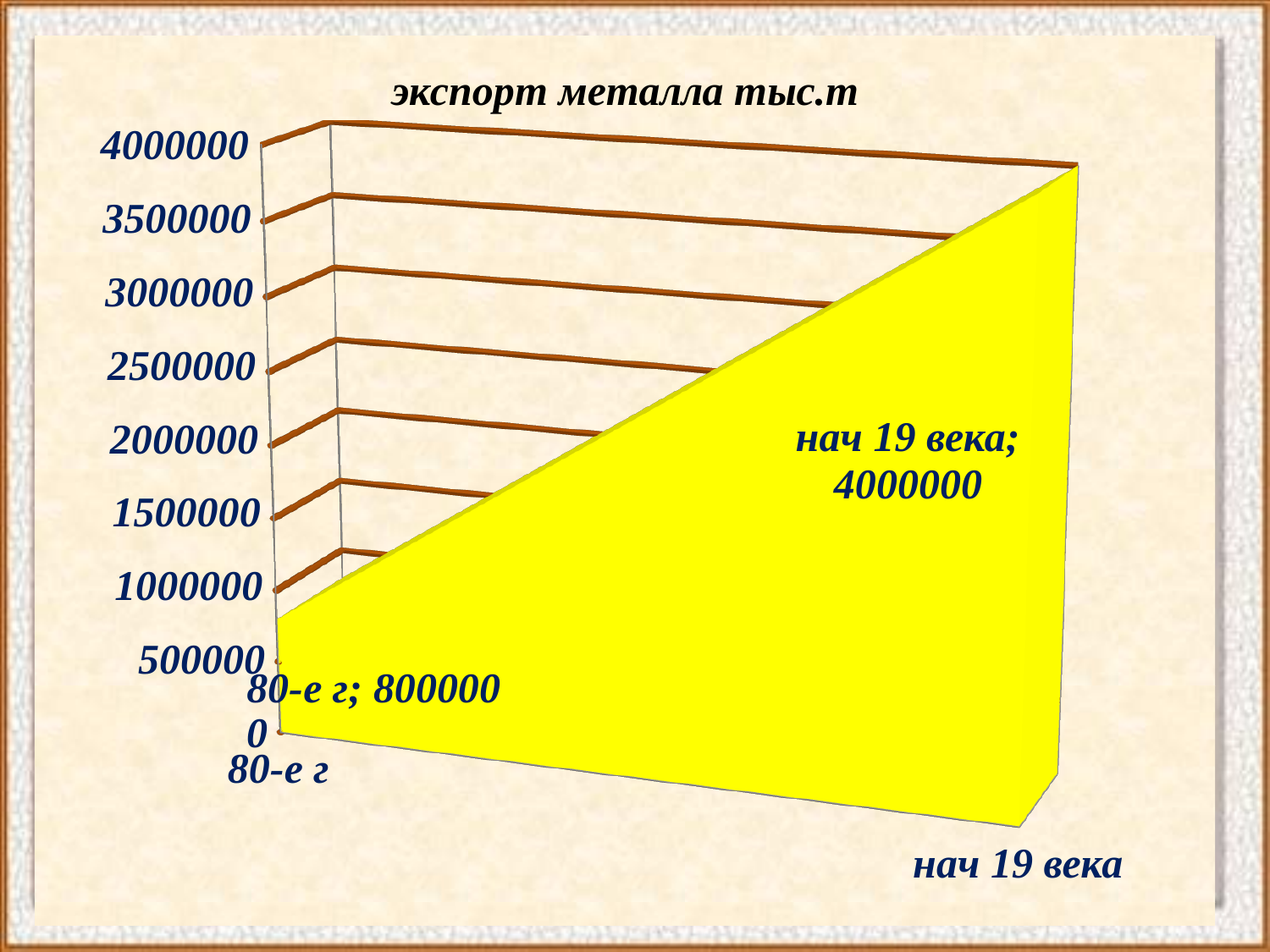
Do the values rise or fall from 80-е г to нач 19 века? rise Which is larger, the value for 80-е г or the value for нач 19 века? нач 19 века What is the title of the chart? экспорт металла тыс.т What kind of chart is shown on the slide? area chart Which category has the highest value? нач 19 века Is the value for 80-е г greater or less than 1000000? less What is the value for 80-е г? 800000 Which category has the lowest value? 80-е г What is the difference between the values for нач 19 века and 80-е г? 3200000 Is the value for нач 19 века greater or less than 3500000? greater How many categories are plotted on the x axis? 2 What is the value for нач 19 века? 4000000